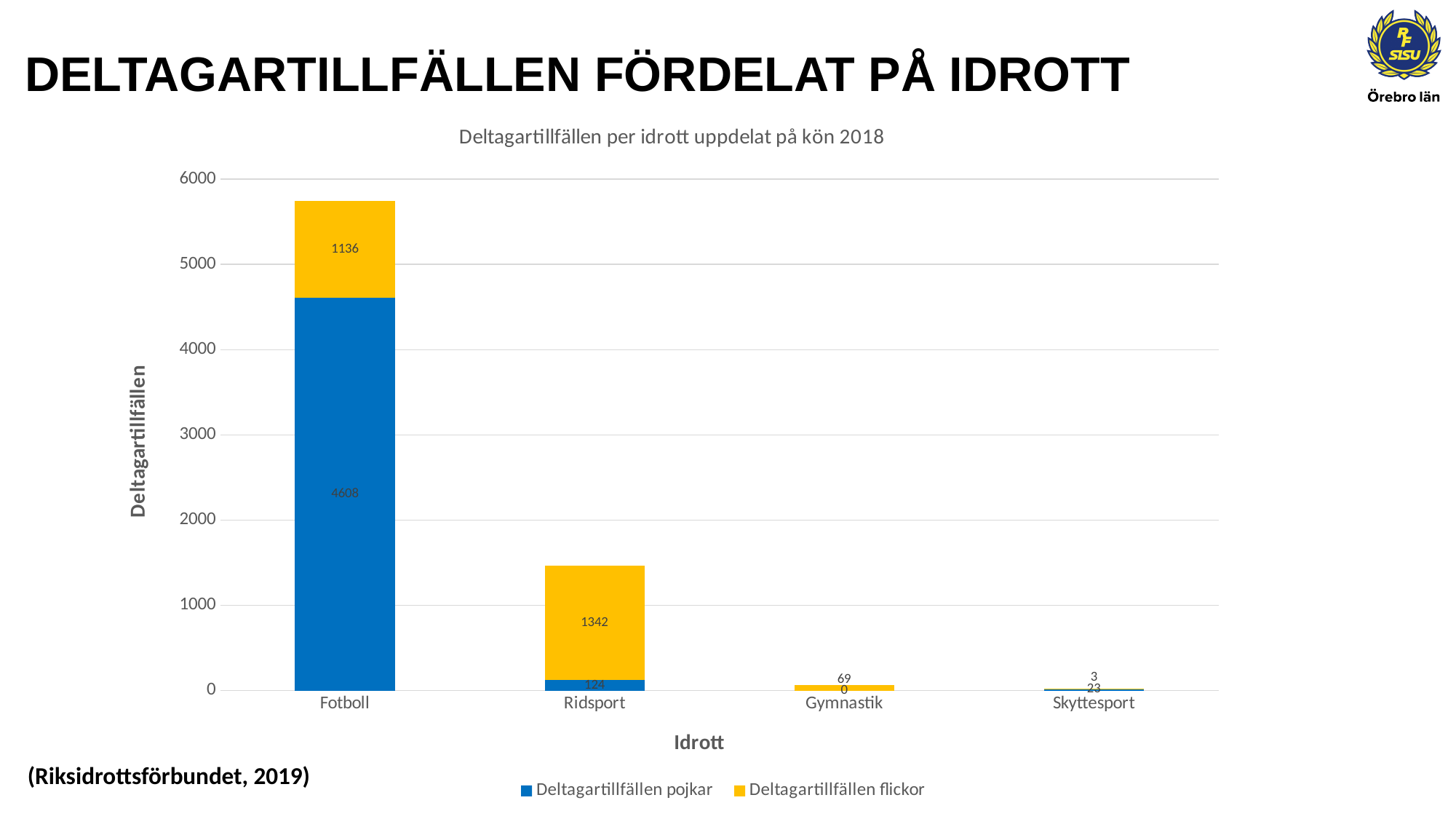
How many series does the legend list? 2 Which sport has the lowest total number of deltagartillfällen? Skyttesport How many sports (categories) are shown on the x axis? 4 What is the value of Deltagartillfällen flickor for Ridsport? 1342 What type of chart is shown on the slide? Stacked bar chart What is the total number of deltagartillfällen for Fotboll (pojkar plus flickor)? 5744 What is the title of the chart? Deltagartillfällen per idrott uppdelat på kön 2018 What is the value of Deltagartillfällen pojkar for Fotboll? 4608 What is the difference between Deltagartillfällen flickor and Deltagartillfällen pojkar for Ridsport? 1218 What is the value of Deltagartillfällen flickor for Fotboll? 1136 Which sport has the highest total number of deltagartillfällen? Fotboll What is the value of Deltagartillfällen pojkar for Ridsport? 124